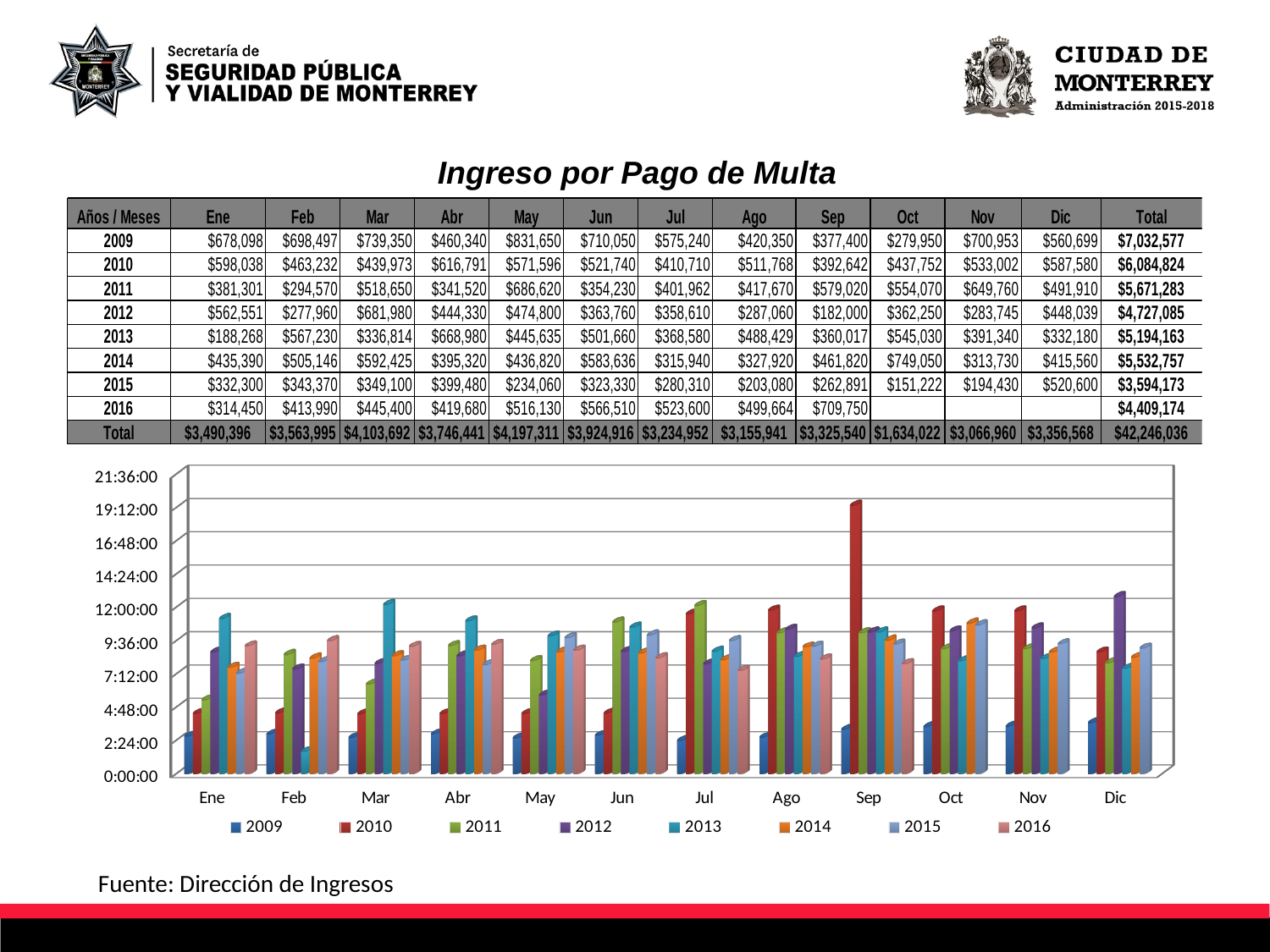
In which month does the 2010 series reach its tallest bar in the chart? Sep In which month does the 2013 series reach its tallest bar in the chart? Mar In Feb, which bar is taller in the chart: 2012 or 2013? 2012 What is the title shown above the table and chart on the slide? Ingreso por Pago de Multa Is the 2010 bar for Sep greater or less than 16:48:00? greater In which month does the 2012 series reach its tallest bar in the chart? Dic How many month categories are shown along the x axis of the chart? 12 How many series does the chart legend list? 8 Which years are listed in the chart legend? 2009, 2010, 2011, 2012, 2013, 2014, 2015, 2016 Is the 2009 bar for Jul greater or less than 4:48:00? less What kind of chart is shown on the slide? bar chart